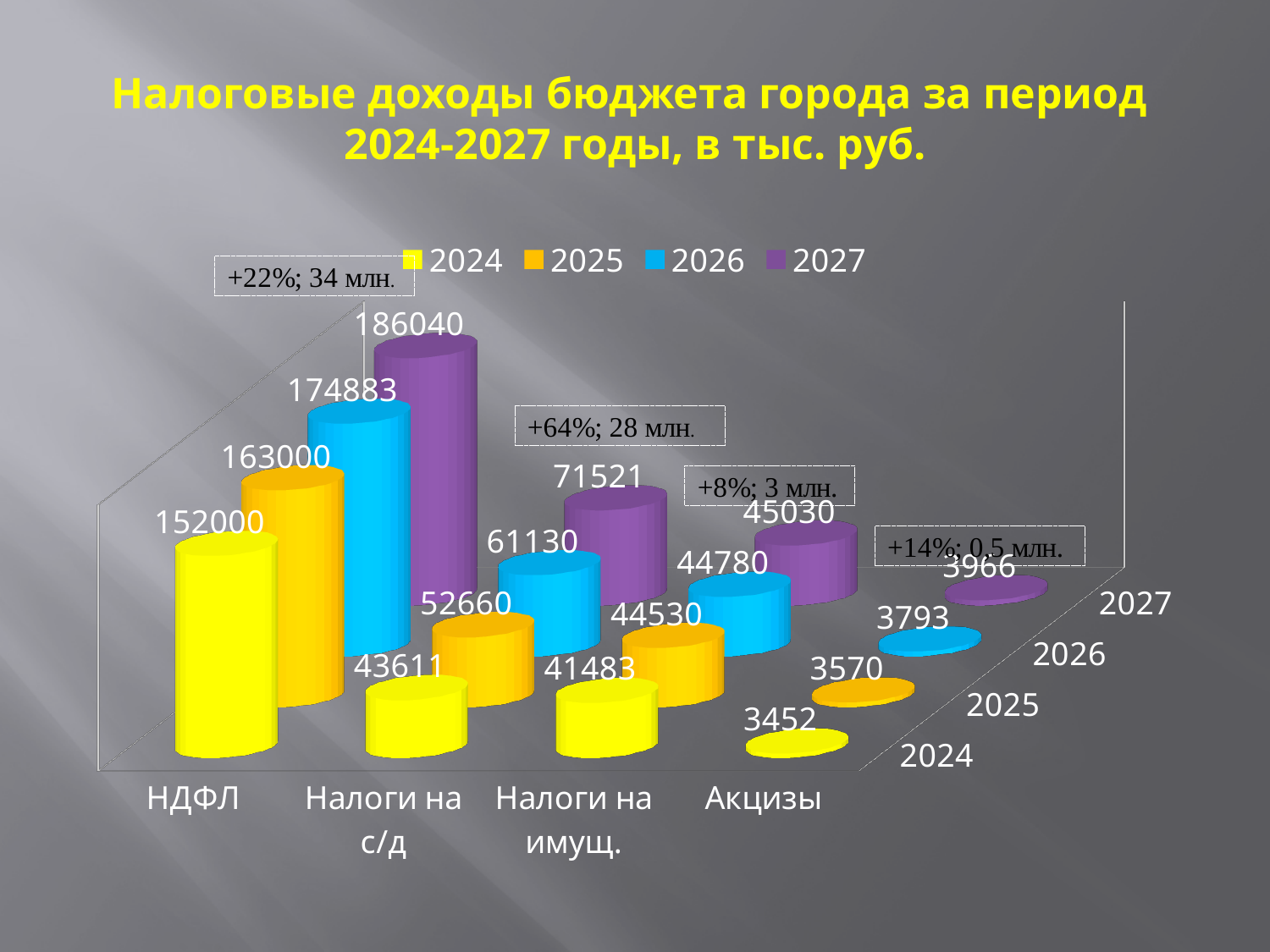
What is the difference between the НДФЛ values for 2027 and 2024? 34040 Do the values for Акцизы rise or fall from 2024 to 2027? rise Which category has the highest value in 2027? НДФЛ Which category has the lowest value in 2024? Акцизы How many categories are shown on the x axis? 4 What is the value for НДФЛ in 2024? 152000 What is the value for Акцизы in 2026? 3793 What is the value for Налоги на имущ. in 2025? 44530 How many series does the legend list? 4 Which is larger: Налоги на с/д in 2026 or Налоги на имущ. in 2026? Налоги на с/д in 2026 What kind of chart is this? bar chart What is the value for Налоги на с/д in 2027? 71521